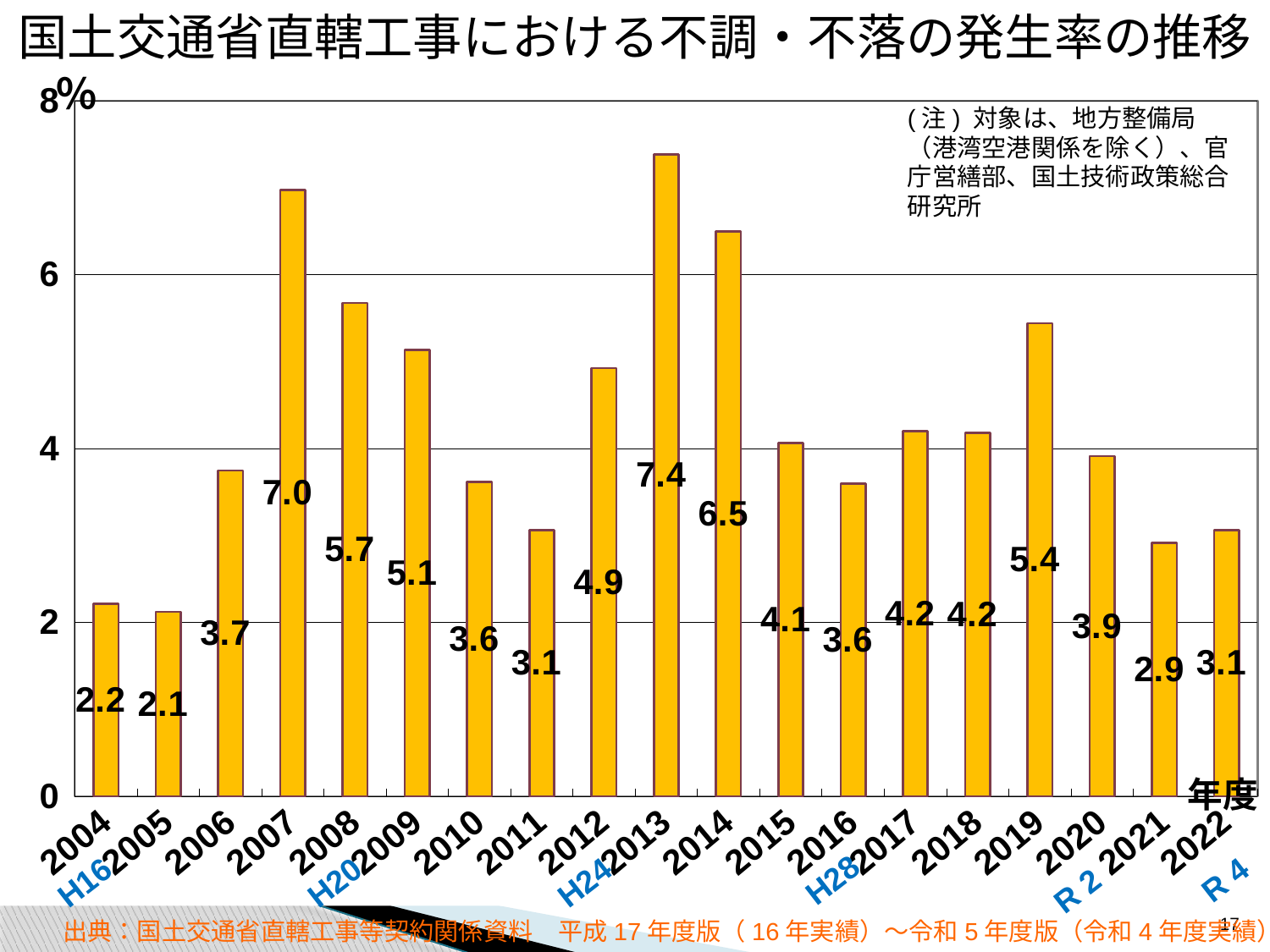
What is the value for 2022? 3.1 Do the values rise or fall from 2019 to 2021? fall What type of chart is shown on the slide? bar chart How many years are shown on the x axis? 19 Which year has the lowest value? 2005 What is the value for 2007? 7.0 What is the value for 2013? 7.4 What is the difference between the values for 2013 and 2014? 0.9 What is the value for 2019? 5.4 Which year has the highest value? 2013 Which is larger, the value for 2008 or the value for 2009? 2008 Is the value for 2012 greater or less than 4? greater